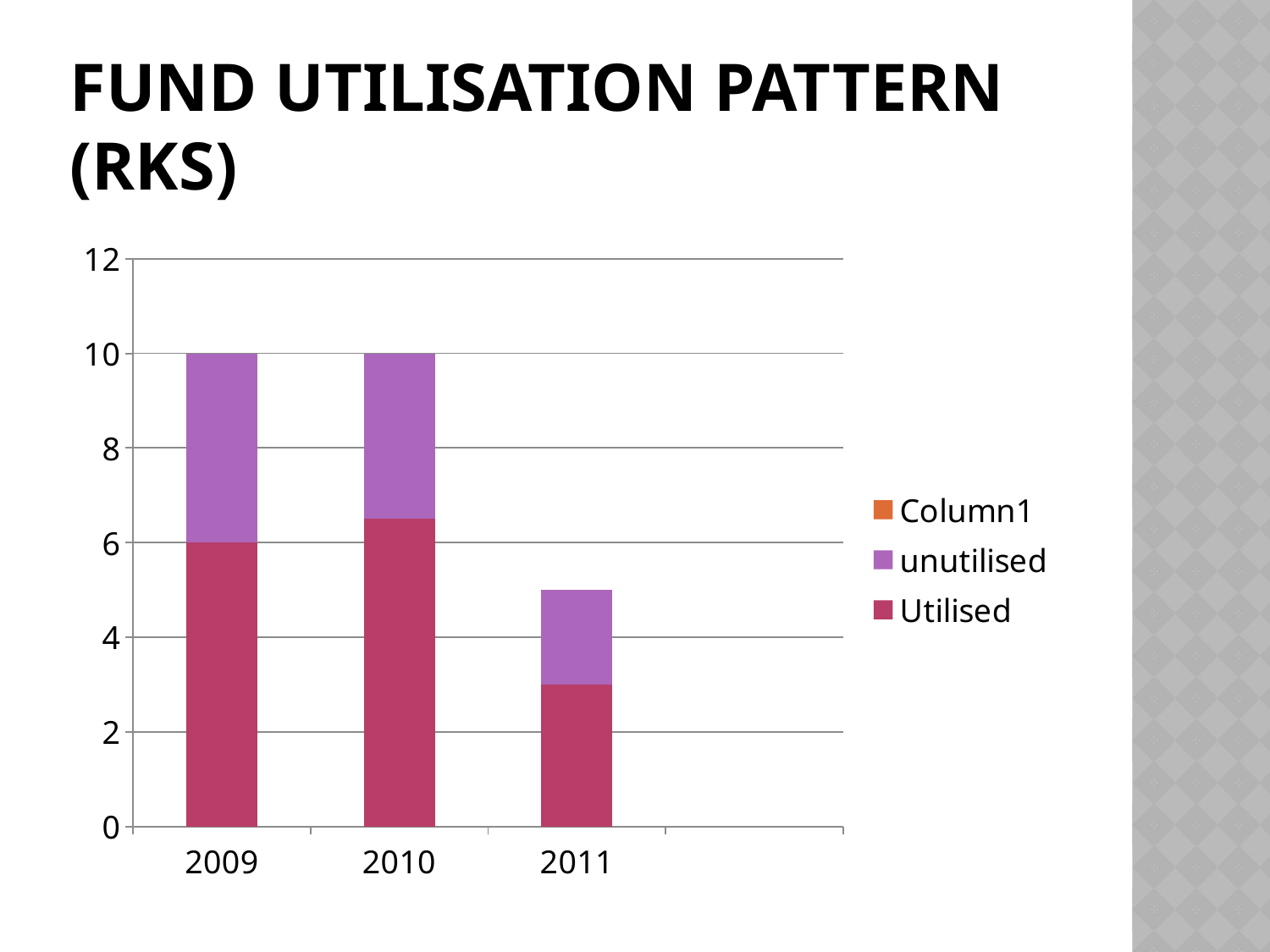
What is the total height of the stacked bar for 2009? 10 What kind of chart is shown on the slide? Stacked bar chart Is the total stacked bar for 2011 greater or less than 6? less Which is larger, the unutilised value for 2009 or for 2011? 2009 What is the total height of the stacked bar for 2010? 10 Which year has the lowest total stacked bar? 2011 How many series does the chart's legend list? 3 What is the Utilised value for 2009? 6 What is the title of the slide containing the chart? FUND UTILISATION PATTERN (RKS) How many years are shown on the x axis of the chart? 3 Which year has the lowest Utilised value? 2011 Is the Utilised value for 2011 greater or less than 4? less